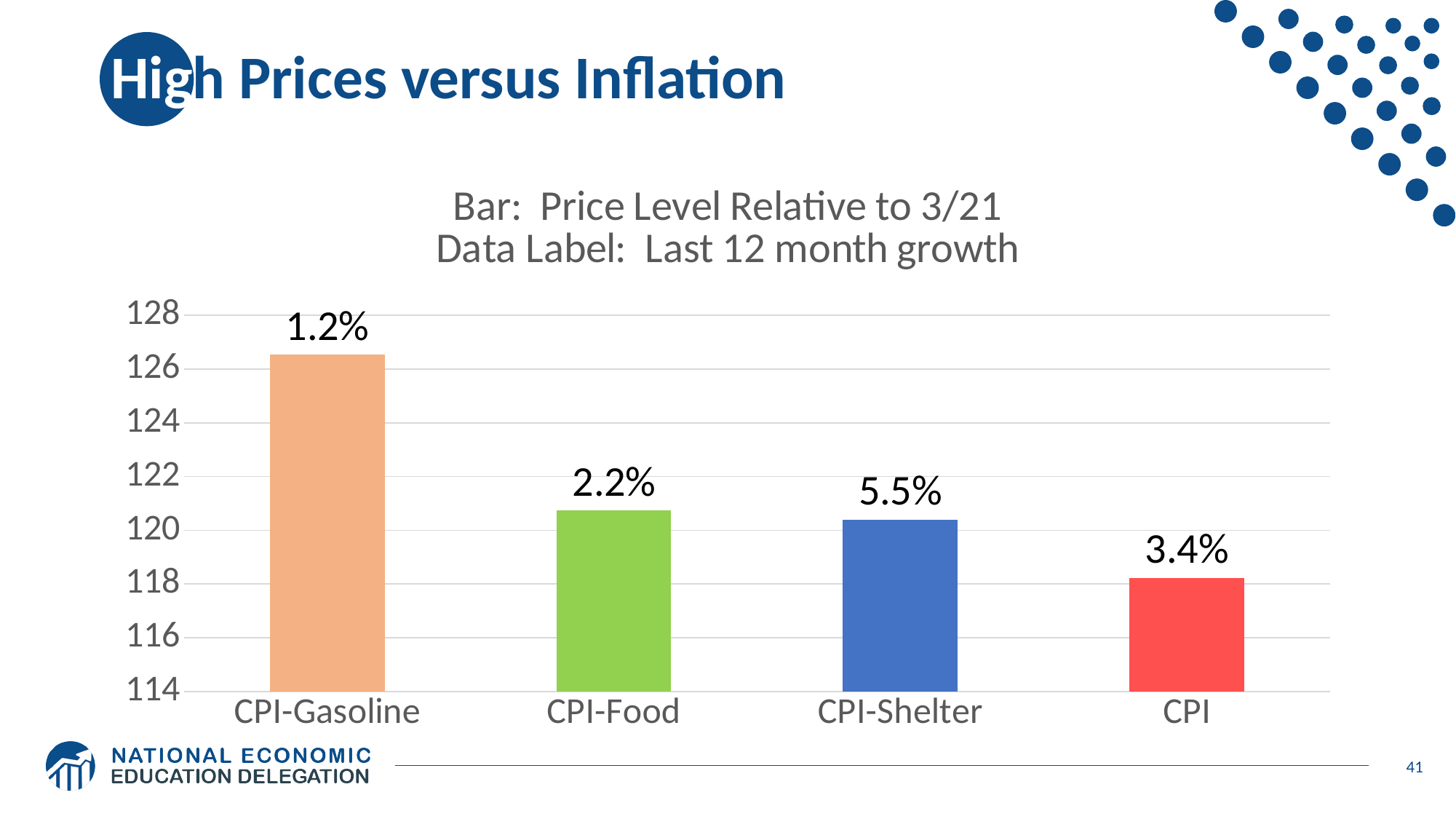
What is the data label shown above the CPI bar? 3.4% Which category has the lowest last 12 month growth data label? CPI-Gasoline Is the bar height for CPI greater or less than 120? less Is the bar height for CPI-Gasoline greater or less than 124? greater Which category has the highest last 12 month growth data label? CPI-Shelter What is the difference between the CPI-Shelter data label and the CPI-Gasoline data label? 4.3 percentage points What is the data label shown above the CPI-Gasoline bar? 1.2% Which category has the shortest bar (lowest price level relative to 3/21)? CPI Which category has the tallest bar (highest price level relative to 3/21)? CPI-Gasoline How many categories are shown on the x axis of the chart? 4 What is the last 12 month growth shown as the data label for CPI-Shelter? 5.5% Is the data label for CPI-Food larger or smaller than the data label for CPI-Shelter? smaller